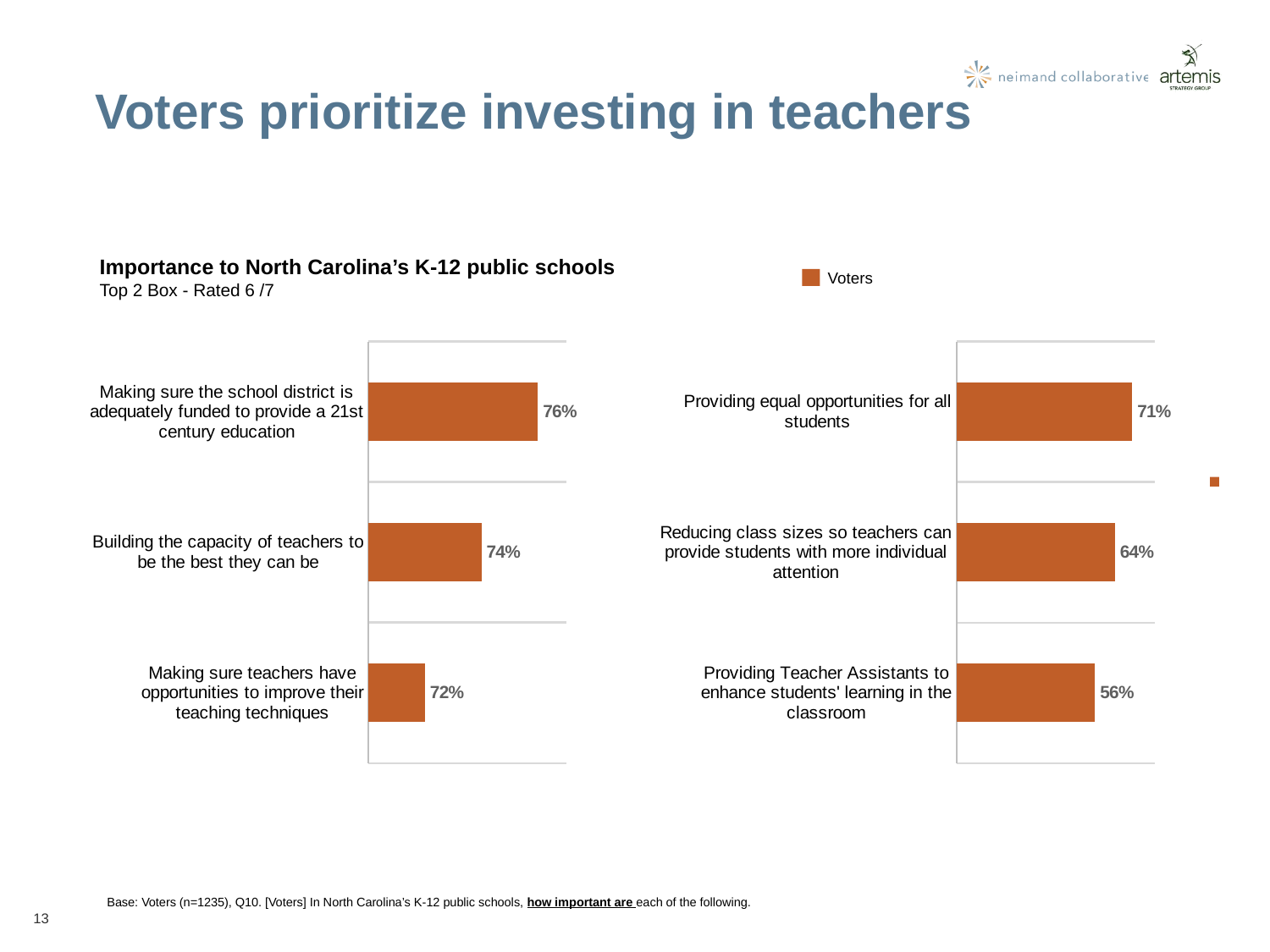
In the right chart, which category has the lowest value? Providing Teacher Assistants to enhance students' learning in the classroom In the right chart, what is the value for 'Providing equal opportunities for all students'? 71% In the left chart, what percentage of voters rated 'Making sure the school district is adequately funded to provide a 21st century education' as important? 76% In the left chart, what is the value for 'Building the capacity of teachers to be the best they can be'? 74% What type of chart is used on this slide? Bar chart In the right chart, what is the difference between the values for 'Providing equal opportunities for all students' and 'Reducing class sizes so teachers can provide students with more individual attention'? 7% In the left chart, what is the difference between the highest and lowest values? 4% Which is larger: the value for 'Making sure teachers have opportunities to improve their teaching techniques' in the left chart or 'Reducing class sizes so teachers can provide students with more individual attention' in the right chart? Making sure teachers have opportunities to improve their teaching techniques In the right chart, what percentage is shown for 'Providing Teacher Assistants to enhance students' learning in the classroom'? 56% In the left chart, which category has the highest value? Making sure the school district is adequately funded to provide a 21st century education How many categories are shown in the right chart? 3 What series does the legend list? Voters